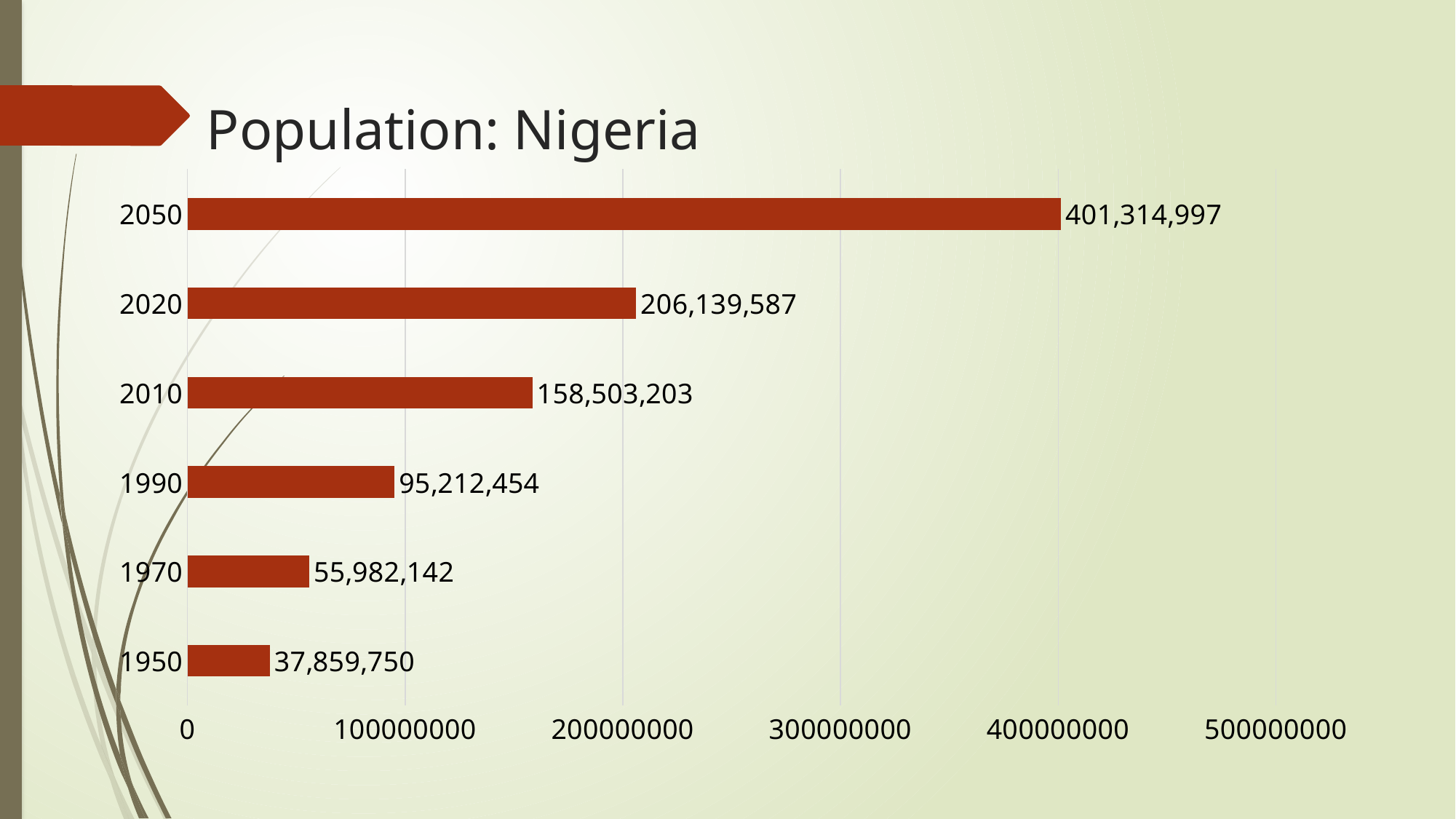
Is the population value for 2020 greater or less than 200000000? greater What is the difference between the population values for 1970 and 1950? 18,122,392 What is the difference between the population values for 2050 and 2020? 195,175,410 Does the population rise or fall from 1950 to 2050? rise Which is larger, the population value for 2010 or for 1990? 2010 What is the population value shown for 1950? 37,859,750 Which year has the lowest population value on the chart? 1950 Which year has the highest population value on the chart? 2050 What is the population value shown for 1990? 95,212,454 How many years are shown on the chart? 6 What is the population value shown for 2050? 401,314,997 What kind of chart is shown on the slide? bar chart